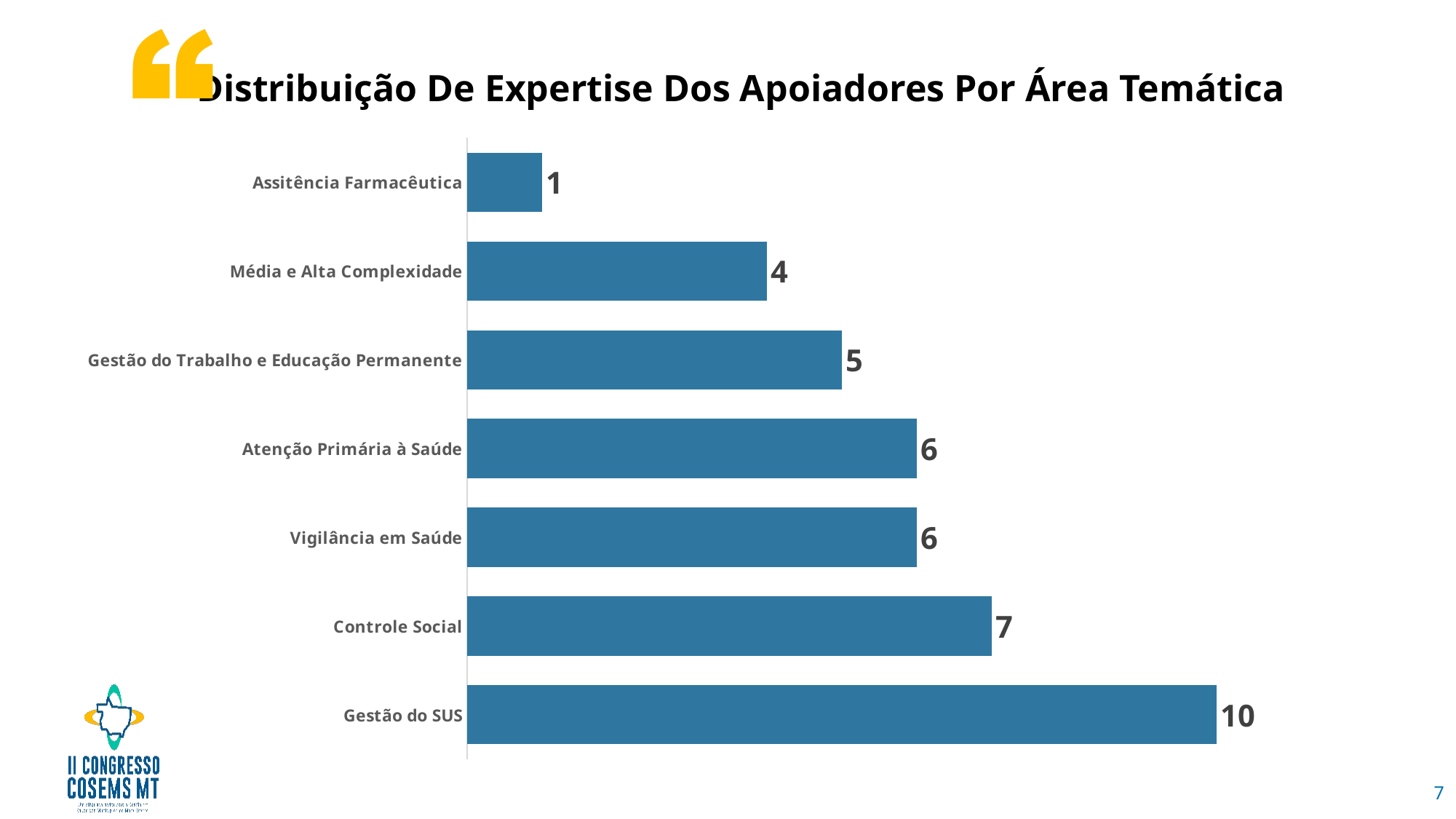
What is the difference between the values for Atenção Primária à Saúde and Assitência Farmacêutica? 5 What is the value for Média e Alta Complexidade? 4 Which category has the highest value? Gestão do SUS Which is larger, the value for Vigilância em Saúde or the value for Média e Alta Complexidade? Vigilância em Saúde What is the difference between the values for Gestão do SUS and Controle Social? 3 Which category has the lowest value? Assitência Farmacêutica What is the value for Gestão do Trabalho e Educação Permanente? 5 What is the value for Controle Social? 7 How many categories are shown in the chart? 7 What is the value for Gestão do SUS? 10 What is the title of the chart? Distribuição De Expertise Dos Apoiadores Por Área Temática What kind of chart is shown on the slide? Bar chart